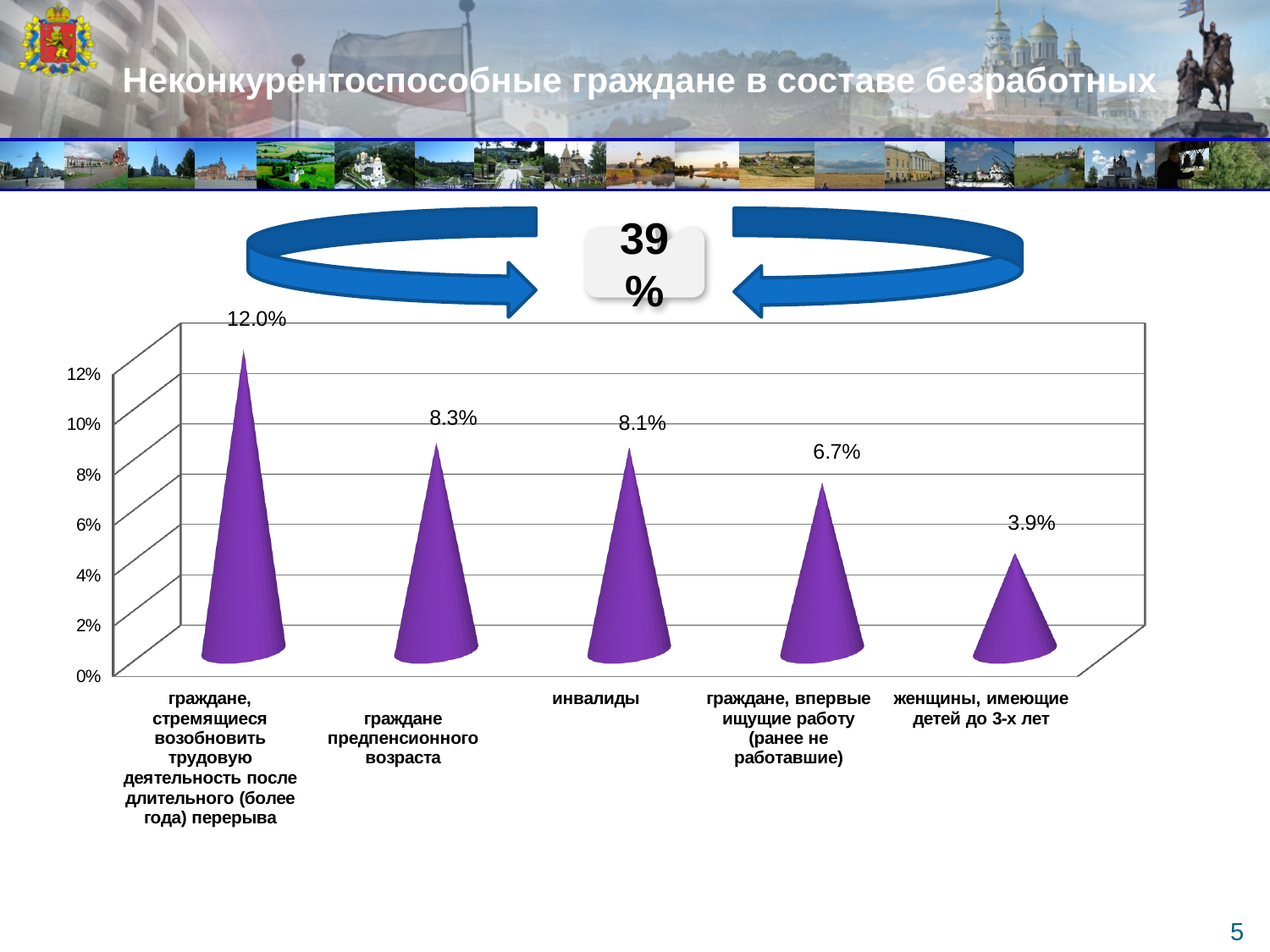
Which category has the lowest value? женщины, имеющие детей до 3-х лет What is the difference between the value for граждане предпенсионного возраста and the value for инвалиды? 0.2% What is the value for женщины, имеющие детей до 3-х лет? 3.9% What is the value for инвалиды? 8.1% Which category has the highest value? граждане, стремящиеся возобновить трудовую деятельность после длительного (более года) перерыва What kind of chart is shown on the slide? bar chart What is the value for граждане, впервые ищущие работу (ранее не работавшие)? 6.7% What is the difference between the value for граждане, стремящиеся возобновить трудовую деятельность после длительного (более года) перерыва and the value for женщины, имеющие детей до 3-х лет? 8.1% How many categories are shown in the chart? 5 Which is larger: the value for инвалиды or the value for граждане, впервые ищущие работу (ранее не работавшие)? инвалиды Do the values rise or fall from left to right across the categories? fall What is the value for граждане предпенсионного возраста? 8.3%